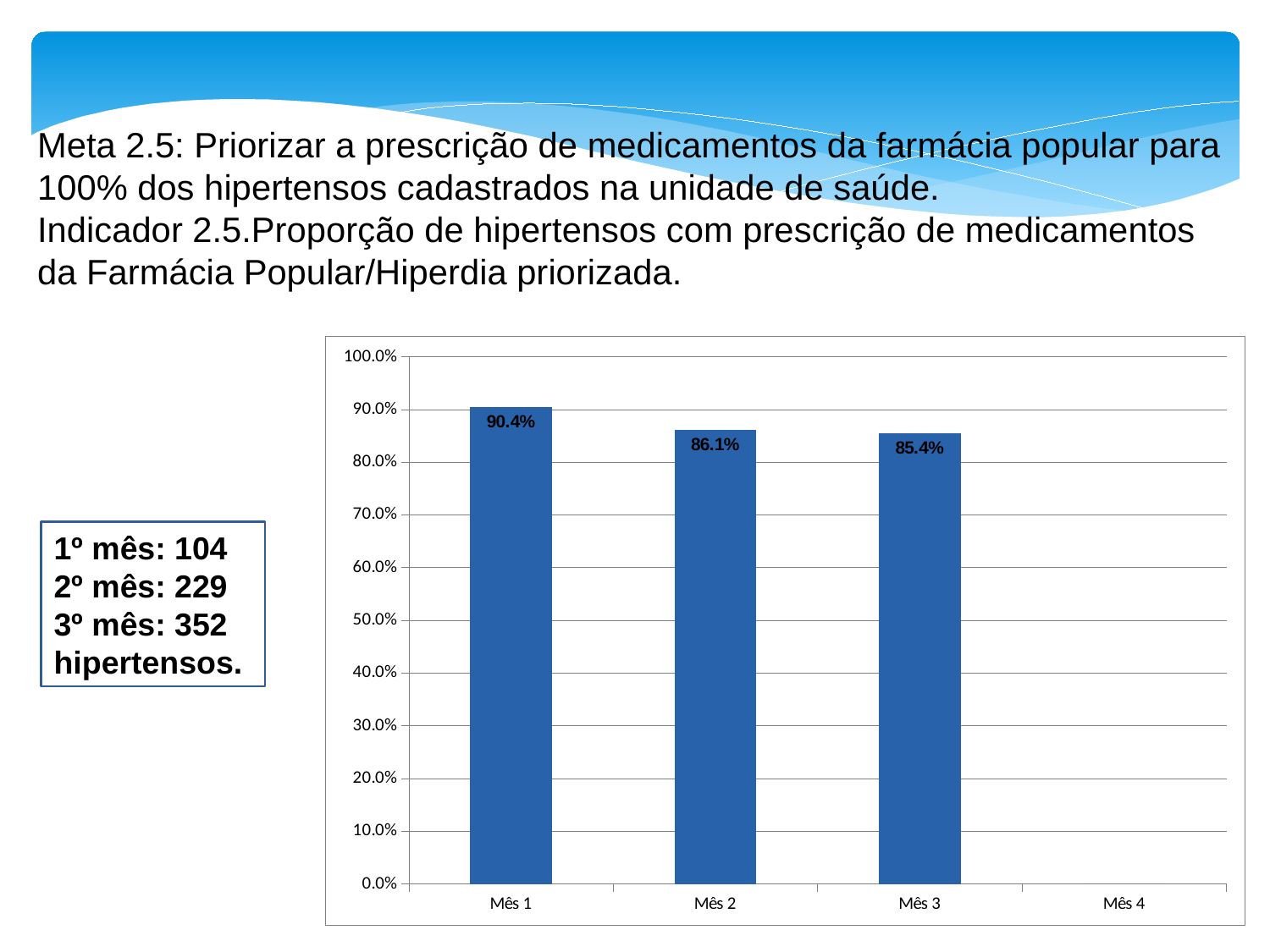
Which is larger, the value for Mês 1 or the value for Mês 2? Mês 1 How many categories are shown on the x axis? 4 Is the value for Mês 2 greater or less than 90.0%? less What kind of chart is shown on the slide? bar chart Which month with a plotted bar has the lowest value? Mês 3 What is the value for Mês 1? 90.4% What is the difference between the values for Mês 1 and Mês 3? 5.0% What is the value for Mês 2? 86.1% What is the value for Mês 3? 85.4% What is the difference between the values for Mês 1 and Mês 2? 4.3% Do the values rise or fall from Mês 1 to Mês 3? fall Which month has the highest value? Mês 1